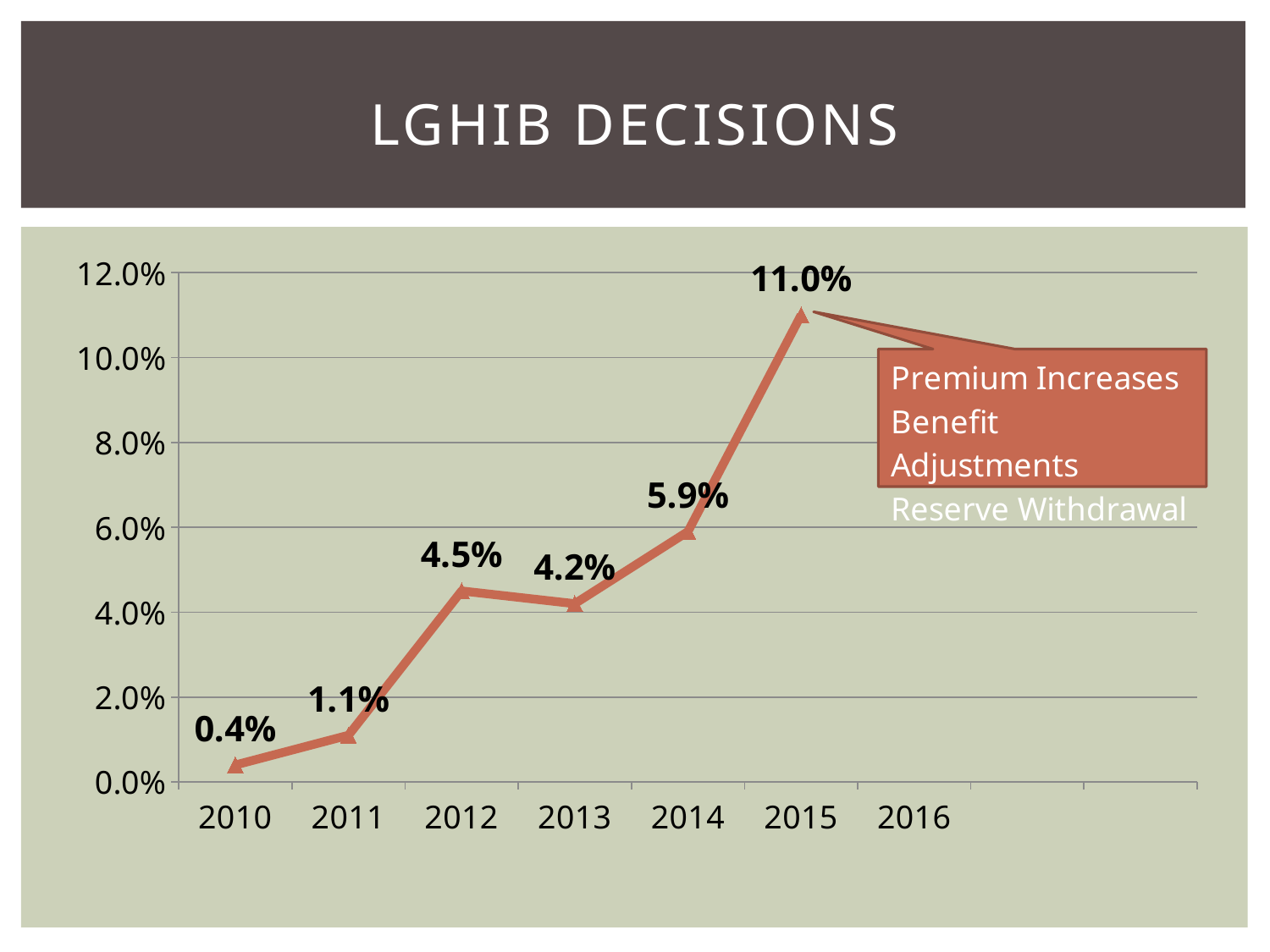
Is the value for 2014 greater or less than 4.0%? greater What is the difference between the values for 2015 and 2014? 5.1% What is the difference between the values for 2012 and 2013? 0.3% What is the value for 2010? 0.4% Which is larger, the value for 2012 or the value for 2013? 2012 What kind of chart is shown on the slide? Line chart Which year has the lowest value? 2010 What is the value for 2015? 11.0% How many data points are plotted on the line? 6 What is the title of the slide containing the chart? LGHIB DECISIONS Which year has the highest value? 2015 What is the value for 2013? 4.2%